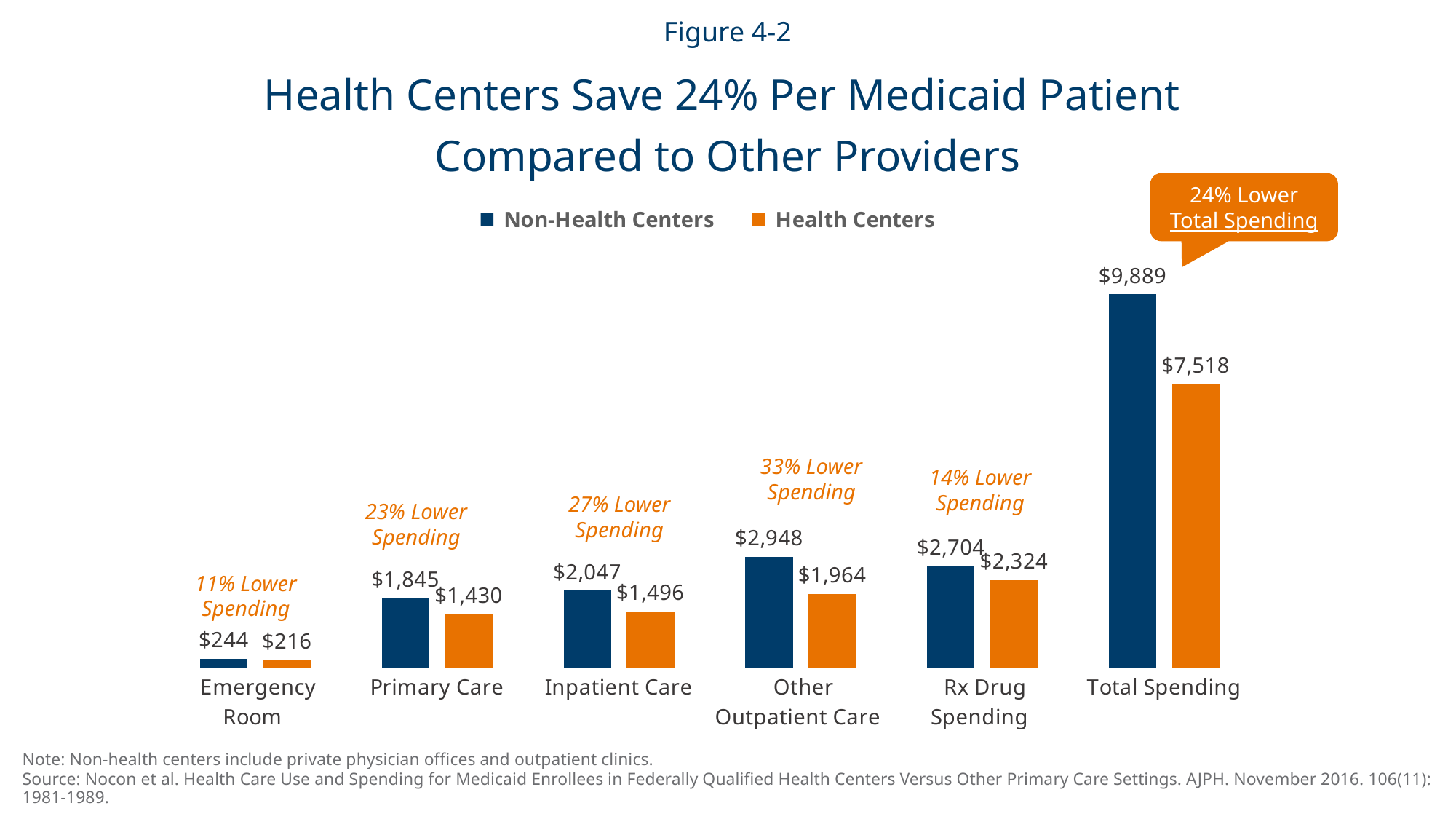
What is the Non-Health Centers value for Other Outpatient Care? $2,948 Which category has the lowest Health Centers value? Emergency Room What is the difference between the Non-Health Centers and Health Centers values for Total Spending? $2,371 What is the difference between the Non-Health Centers and Health Centers values for Inpatient Care? $551 What kind of chart is shown on the slide? Bar chart What is the Health Centers value for Total Spending? $7,518 What is the Health Centers value for Primary Care? $1,430 How many series does the legend list? 2 Which category has the highest Non-Health Centers value? Total Spending Which is larger for Rx Drug Spending: the Non-Health Centers value or the Health Centers value? Non-Health Centers How many categories are shown on the x axis? 6 What is the Non-Health Centers value for Emergency Room? $244